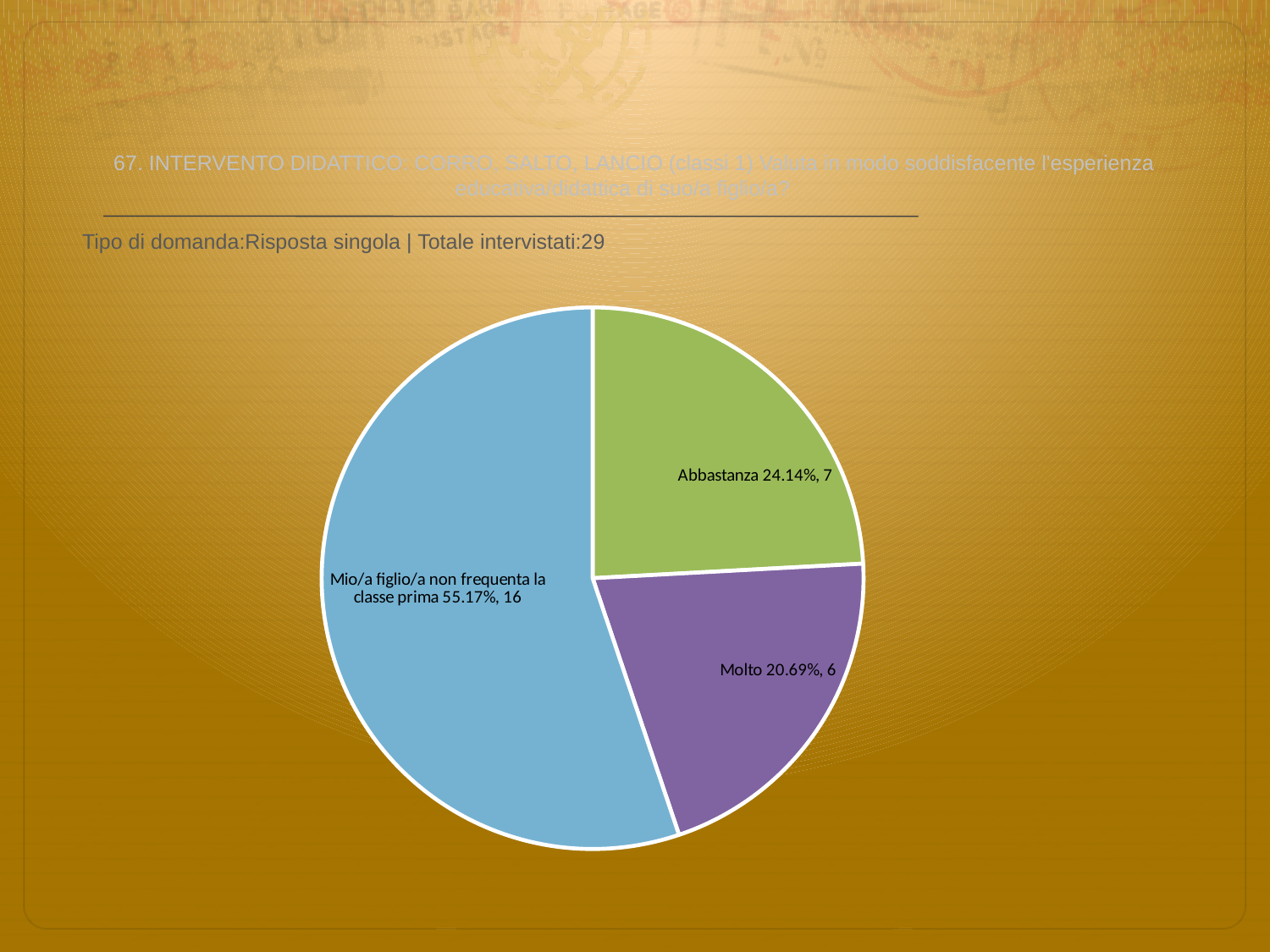
What colour is the 'Molto' slice? purple Which slice is the largest? Mio/a figlio/a non frequenta la classe prima What percentage is shown for 'Mio/a figlio/a non frequenta la classe prima'? 55.17% How many respondents chose 'Molto'? 6 What percentage is shown for the 'Abbastanza' slice? 24.14% How many respondents chose 'Mio/a figlio/a non frequenta la classe prima'? 16 Which has more respondents, 'Abbastanza' or 'Molto'? Abbastanza How many slices does the pie chart have? 3 What is the total number of respondents stated on the slide? 29 What is the difference in respondent count between 'Mio/a figlio/a non frequenta la classe prima' and 'Abbastanza'? 9 What kind of chart is shown on the slide? pie chart Which slice is the smallest? Molto